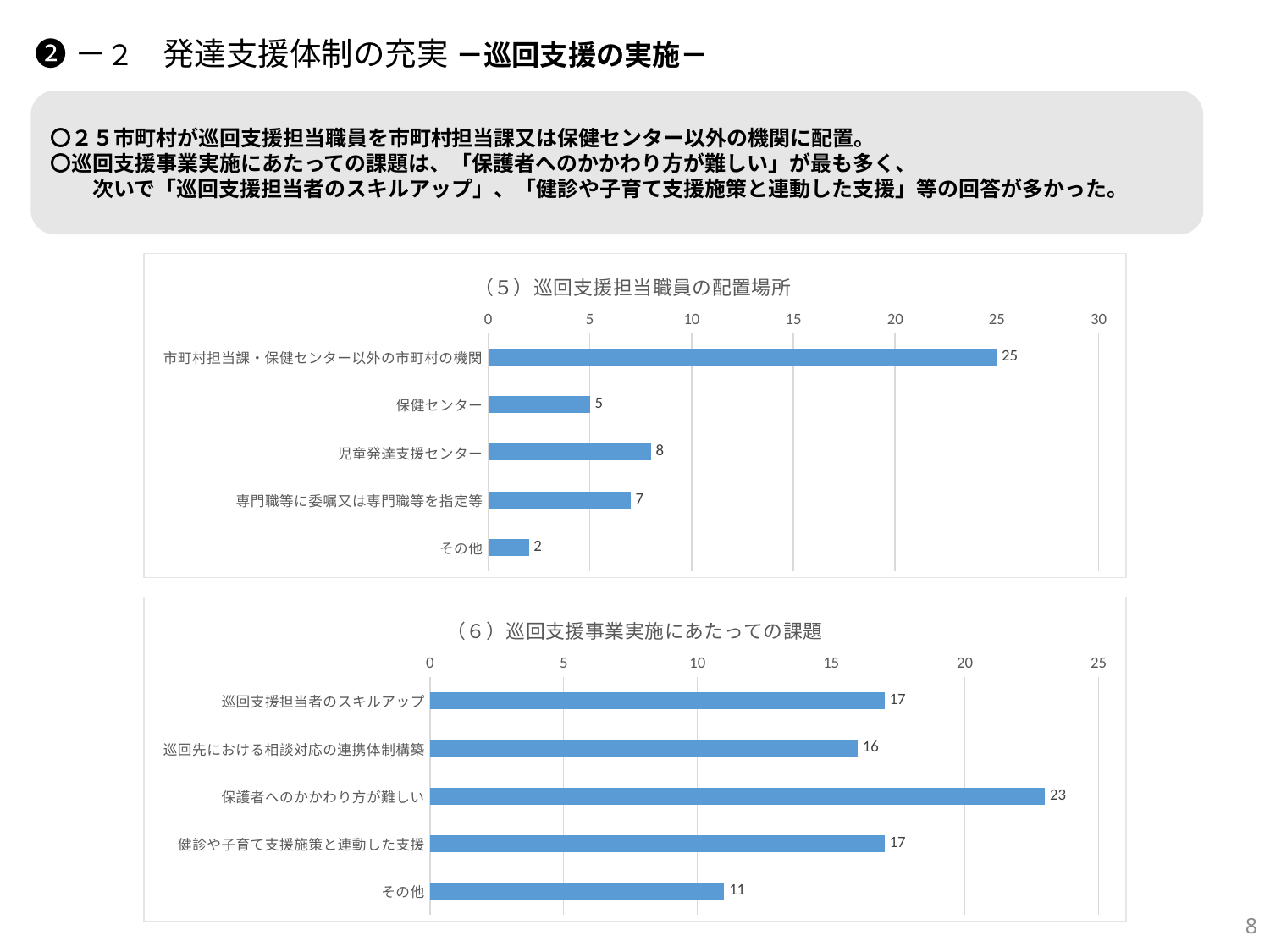
In the chart titled （５）巡回支援担当職員の配置場所, which category has the lowest value? その他 In the chart titled （６）巡回支援事業実施にあたっての課題, which category has the lowest value? その他 In the chart titled （５）巡回支援担当職員の配置場所, which category has the highest value? 市町村担当課・保健センター以外の市町村の機関 In the chart titled （６）巡回支援事業実施にあたっての課題, what is the value for その他? 11 What kind of chart is the chart titled （５）巡回支援担当職員の配置場所? Bar chart What is the title of the lower chart on the slide? （６）巡回支援事業実施にあたっての課題 In the chart titled （５）巡回支援担当職員の配置場所, how many categories are shown? 5 In the chart titled （５）巡回支援担当職員の配置場所, what is the value for 保健センター? 5 In the chart titled （５）巡回支援担当職員の配置場所, what is the difference between the values for 児童発達支援センター and 専門職等に委嘱又は専門職等を指定等? 1 In the chart titled （６）巡回支援事業実施にあたっての課題, which is larger: 巡回支援担当者のスキルアップ or 巡回先における相談対応の連携体制構築? 巡回支援担当者のスキルアップ In the chart titled （６）巡回支援事業実施にあたっての課題, what is the difference between the values for 保護者へのかかわり方が難しい and 健診や子育て支援施策と連動した支援? 6 In the chart titled （６）巡回支援事業実施にあたっての課題, what is the value for 保護者へのかかわり方が難しい? 23